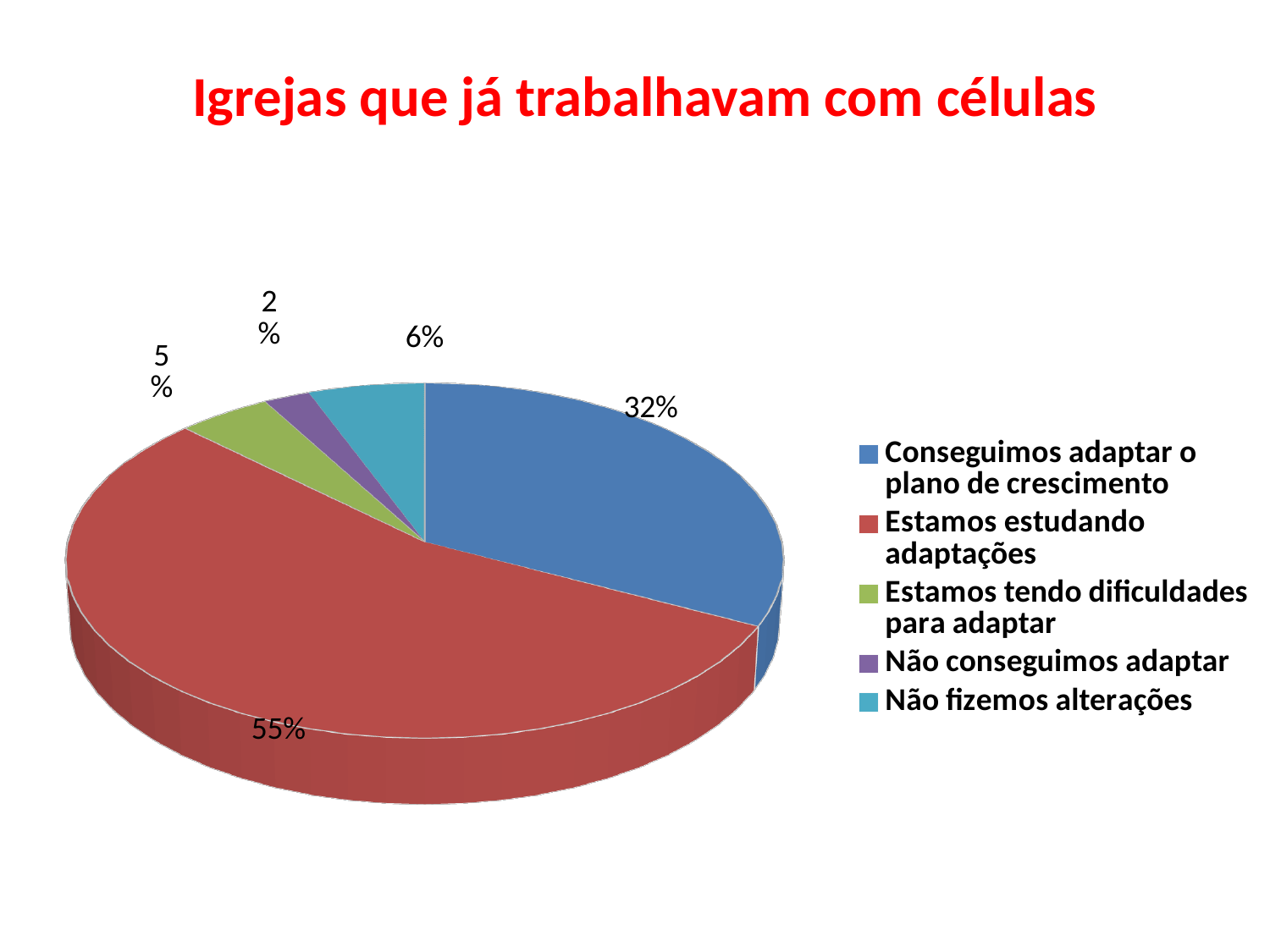
How many categories does the legend list? 5 Which is larger: 'Não fizemos alterações' or 'Estamos tendo dificuldades para adaptar'? Não fizemos alterações What percentage of the pie is 'Conseguimos adaptar o plano de crescimento'? 32% Which category has the largest share of the pie? Estamos estudando adaptações What is the title of the chart? Igrejas que já trabalhavam com células What percentage of the pie is 'Não fizemos alterações'? 6% What is the difference in percentage points between 'Estamos estudando adaptações' and 'Conseguimos adaptar o plano de crescimento'? 23 What percentage of the pie is 'Estamos estudando adaptações'? 55% What percentage of the pie is 'Estamos tendo dificuldades para adaptar'? 5% What type of chart is shown on the slide? Pie chart Which category has the smallest share of the pie? Não conseguimos adaptar What percentage of the pie is 'Não conseguimos adaptar'? 2%